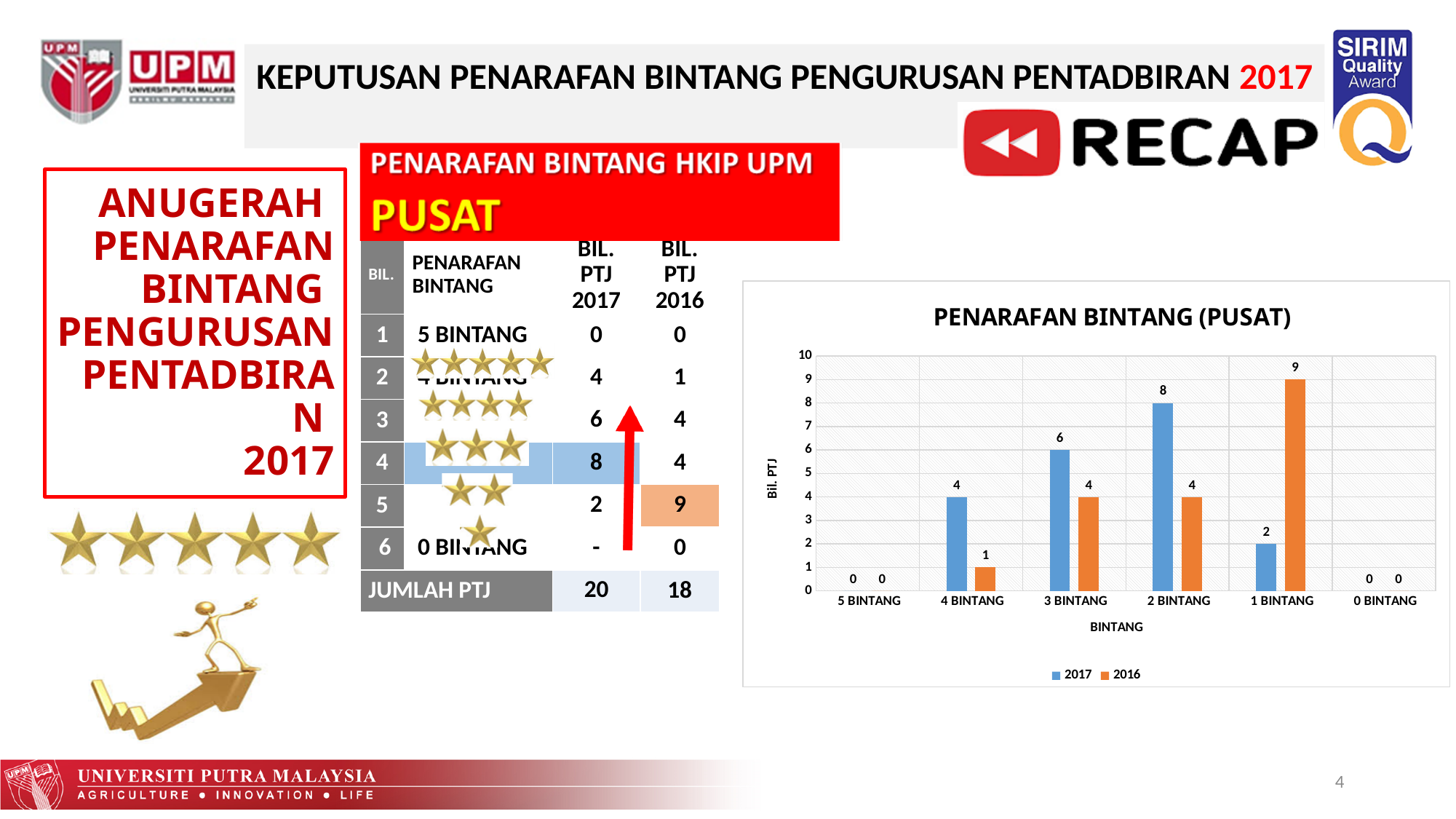
What is the 2016 value for 4 BINTANG? 1 For 1 BINTANG, which is larger, the 2017 value or the 2016 value? 2016 What is the 2016 value for 1 BINTANG? 9 How many categories are shown on the x axis? 6 What is the label of the y axis? Bil. PTJ How many series does the legend list? 2 Which category has the highest 2016 value? 1 BINTANG What type of chart is shown? bar chart What is the 2017 value for 2 BINTANG? 8 What is the title of the chart? PENARAFAN BINTANG (PUSAT) What is the difference between the 2017 and 2016 values for 3 BINTANG? 2 Which category has the highest 2017 value? 2 BINTANG